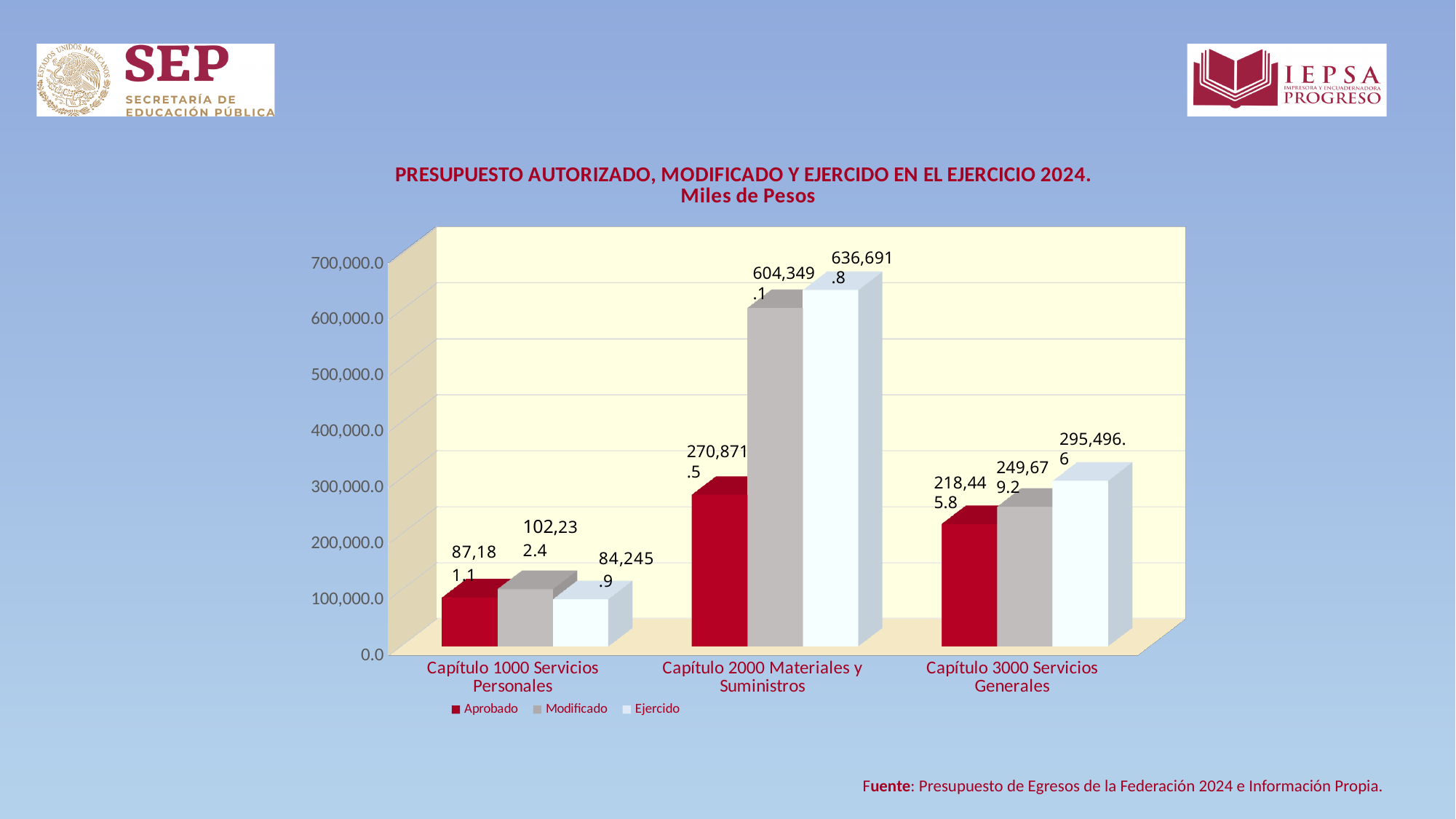
For Capítulo 1000 Servicios Personales, which is larger: the Modificado value or the Ejercido value? Modificado What is the Aprobado value for Capítulo 1000 Servicios Personales? 87,181.1 Which category has the lowest Aprobado value? Capítulo 1000 Servicios Personales What is the difference between the Ejercido and Modificado values for Capítulo 2000 Materiales y Suministros? 32,342.7 What is the Ejercido value for Capítulo 2000 Materiales y Suministros? 636,691.8 Is the Aprobado value for Capítulo 2000 Materiales y Suministros greater or less than 200,000.0? greater How many series does the legend list? 3 How many categories are shown on the x axis? 3 Which category has the highest Ejercido value? Capítulo 2000 Materiales y Suministros What is the difference between the Modificado and Aprobado values for Capítulo 1000 Servicios Personales? 15,051.3 What is the Modificado value for Capítulo 3000 Servicios Generales? 249,679.2 What kind of chart is shown on the slide? Bar chart